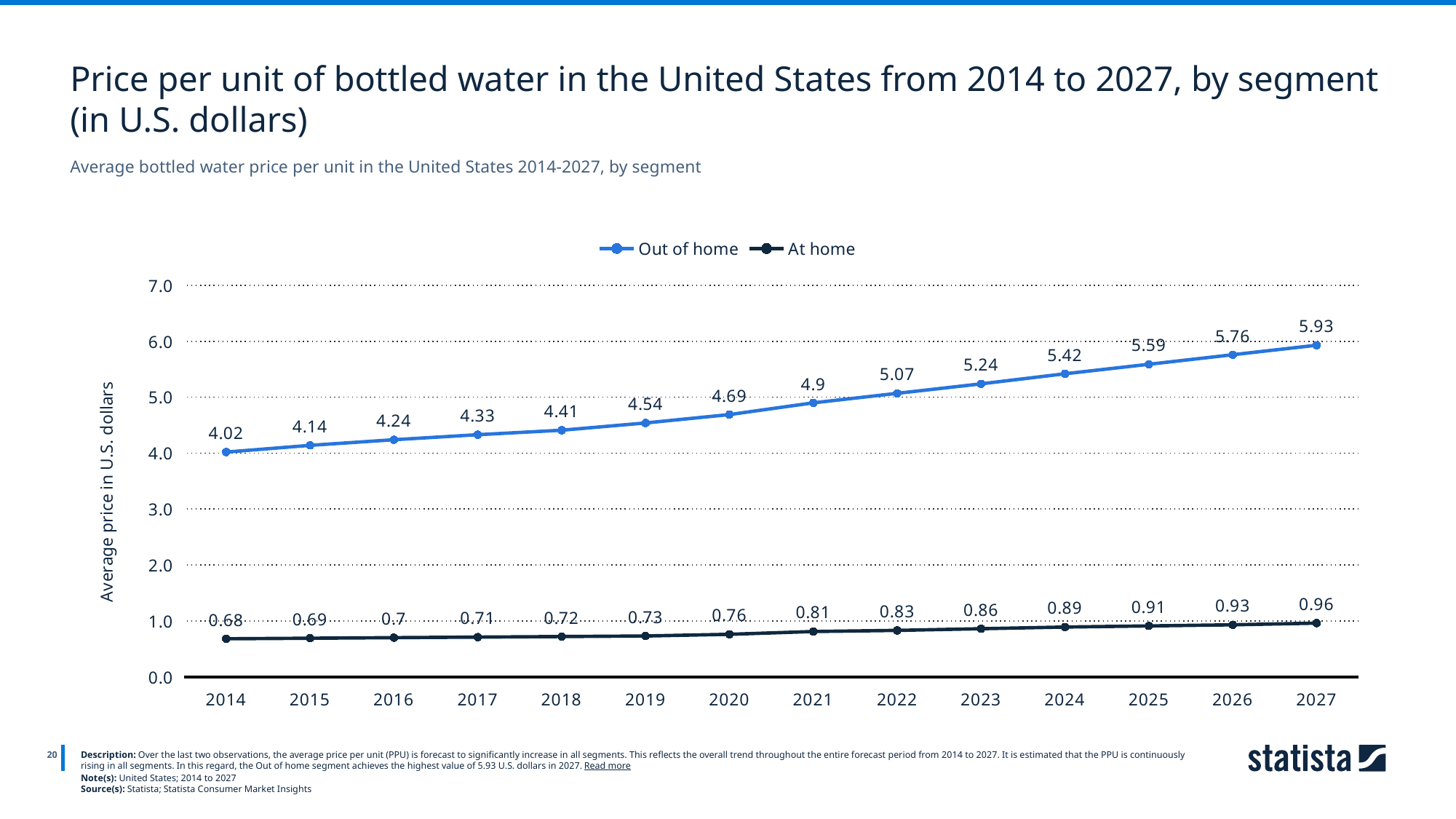
Does the At home price per unit rise or fall from 2014 to 2027? Rise In which year is the Out of home price per unit highest? 2027 What kind of chart is shown on the slide? Line chart What is the difference between the Out of home and At home price per unit in 2027? 4.97 By how much did the Out of home price per unit increase from 2014 to 2027? 1.91 What is the At home price per unit in 2024? 0.89 Is the Out of home price per unit in 2022 greater or less than 5.0? greater How many series does the legend list? 2 In which year is the At home price per unit lowest? 2014 Which segment has the higher price per unit in 2018, Out of home or At home? Out of home How many years are shown on the x axis? 14 What is the Out of home price per unit in 2020? 4.69